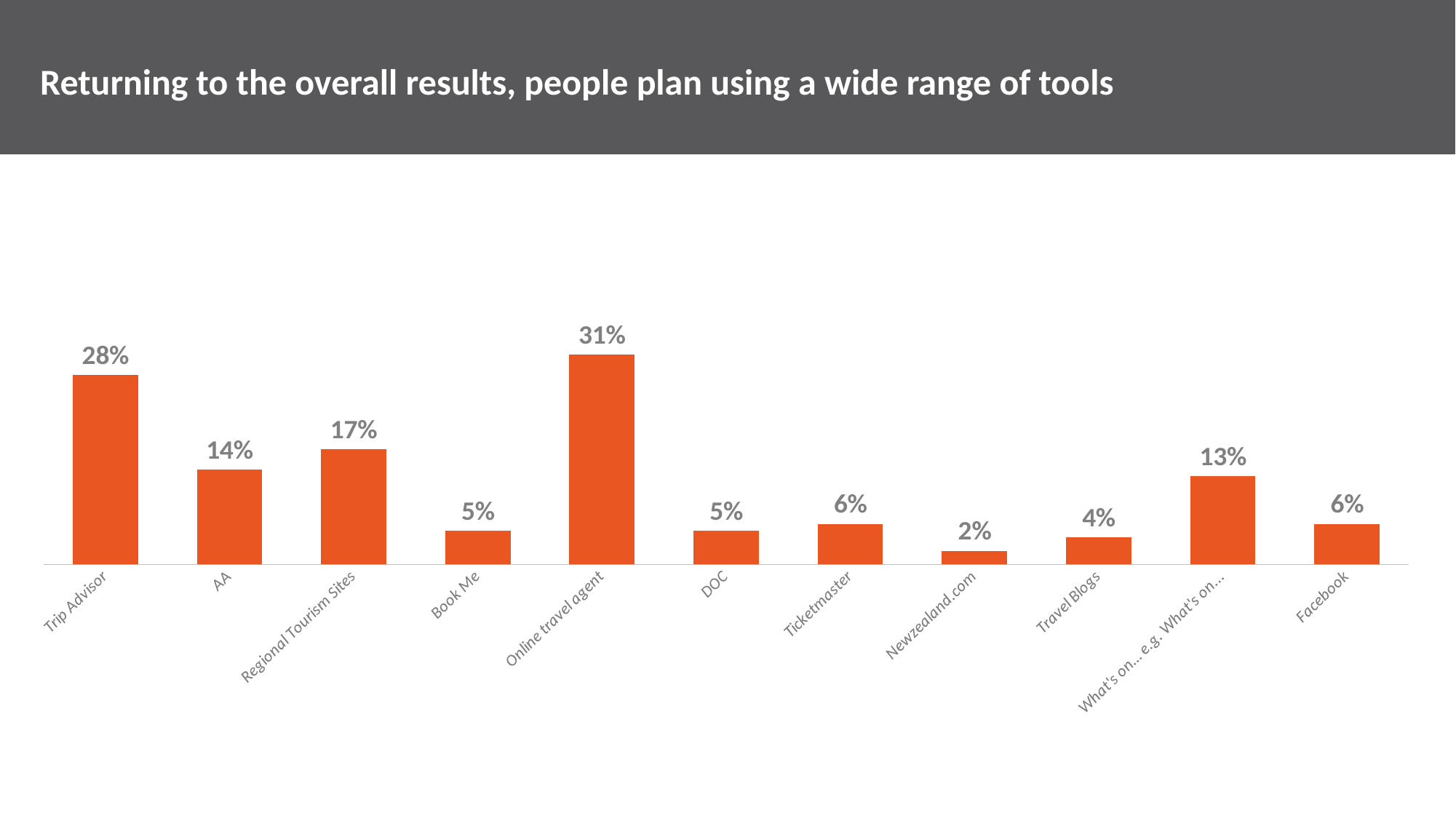
What kind of chart is shown on the slide? Bar chart What is the value for Regional Tourism Sites? 17% What is the difference between the values for Ticketmaster and Travel Blogs? 2% What is the title of the slide? Returning to the overall results, people plan using a wide range of tools What is the value for Newzealand.com? 2% Which category has the lowest value? Newzealand.com Which category has the highest value? Online travel agent What is the difference between the values for Online travel agent and Trip Advisor? 3% Which is larger, the value for AA or the value for Regional Tourism Sites? Regional Tourism Sites What is the value for Trip Advisor? 28% What is the value for Online travel agent? 31% How many categories are shown in the chart? 11